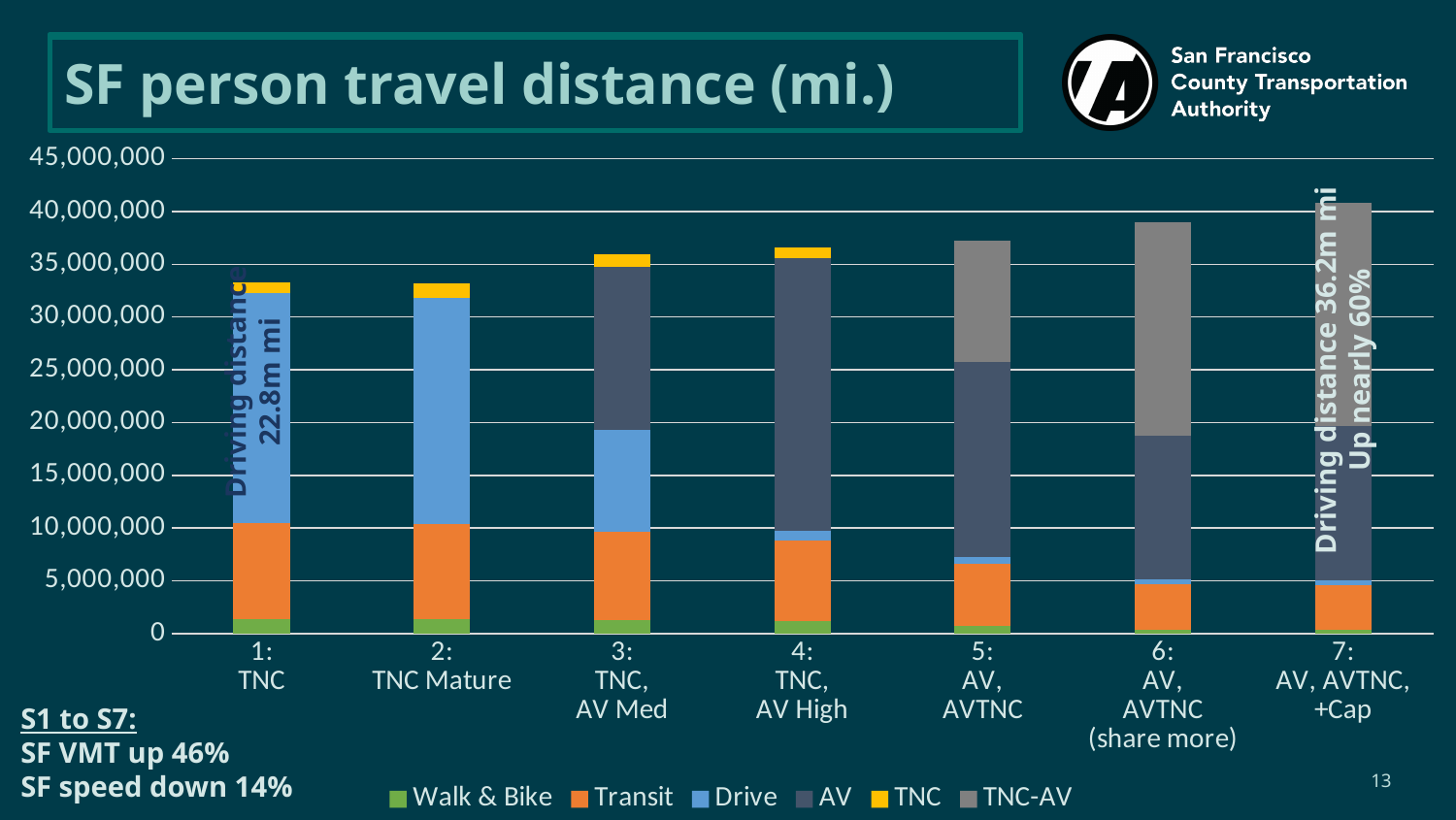
What driving distance is annotated for scenario 7: AV, AVTNC, +Cap? 36.2m mi Is the total for scenario 6: AV, AVTNC (share more) greater or less than 35,000,000? greater Which scenario has the highest total person travel distance? 7: AV, AVTNC, +Cap What kind of chart is shown on the slide? Stacked bar chart How many series does the legend list? 6 What driving distance is annotated for scenario 1: TNC? 22.8m mi Is the total for scenario 1: TNC greater or less than 35,000,000? less Which series are listed in the legend? Walk & Bike, Transit, Drive, AV, TNC, TNC-AV By roughly what percentage does the annotation say driving distance is up in scenario 7? Nearly 60% How many scenarios (categories) are shown along the x axis? 7 Which has the larger total, scenario 2: TNC Mature or scenario 6: AV, AVTNC (share more)? 6: AV, AVTNC (share more) What is the title of the chart? SF person travel distance (mi.)